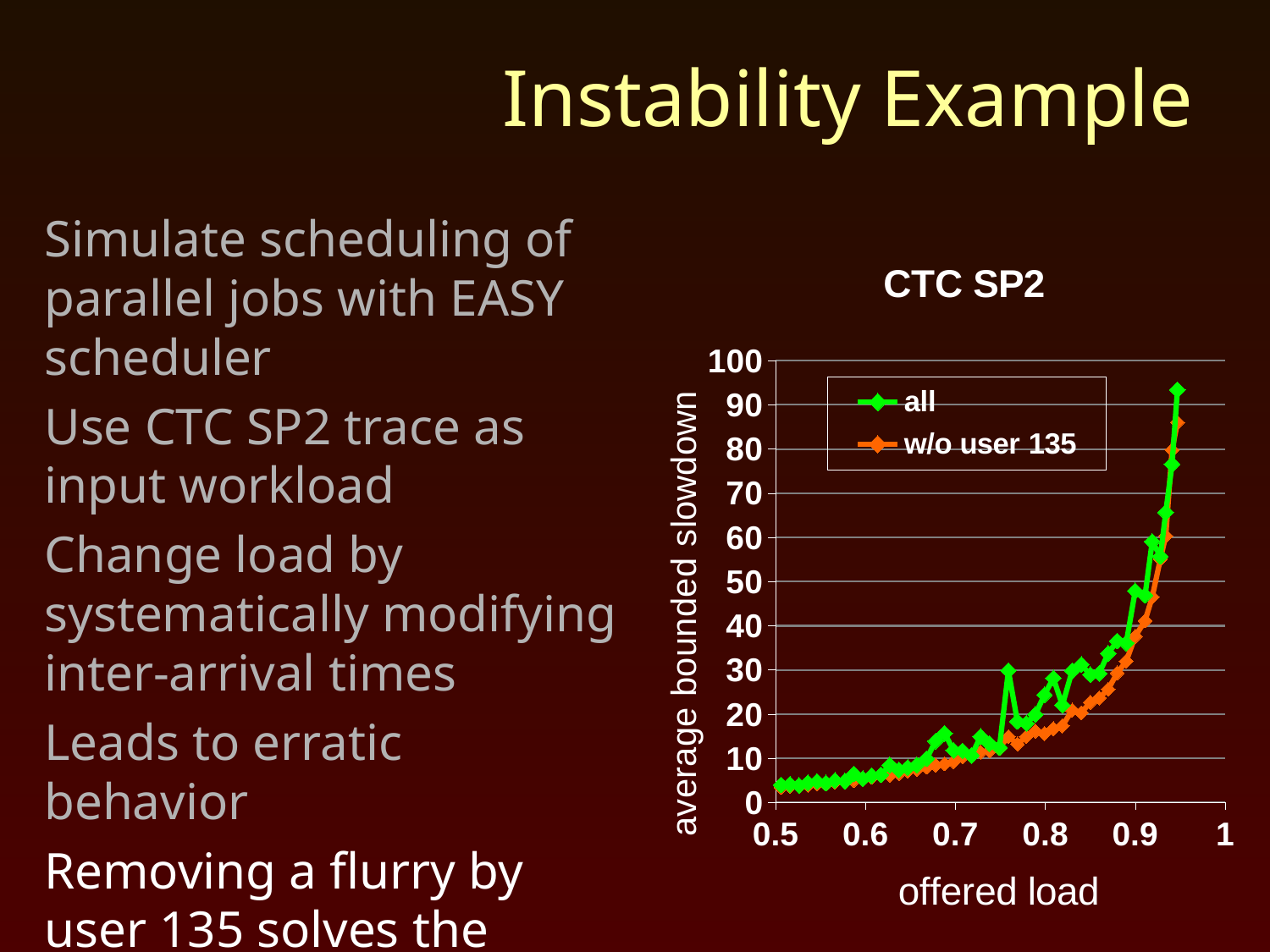
How many series does the chart's legend list? 2 Do the values of the 'all' series generally rise or fall as offered load increases? rise Is the value of the 'all' series at an offered load of 0.5 greater or less than 10? less What kind of chart is shown on the slide? line chart What is the label of the x axis? offered load What are the two series named in the legend? all; w/o user 135 At an offered load of about 0.76, which series has the larger average bounded slowdown, 'all' or 'w/o user 135'? all Which series reaches the highest average bounded slowdown on the chart? all What is the maximum value shown on the y axis? 100 Is the highest value of the 'all' series greater or less than 80? greater What is the label of the y axis? average bounded slowdown What is the title of the chart? CTC SP2